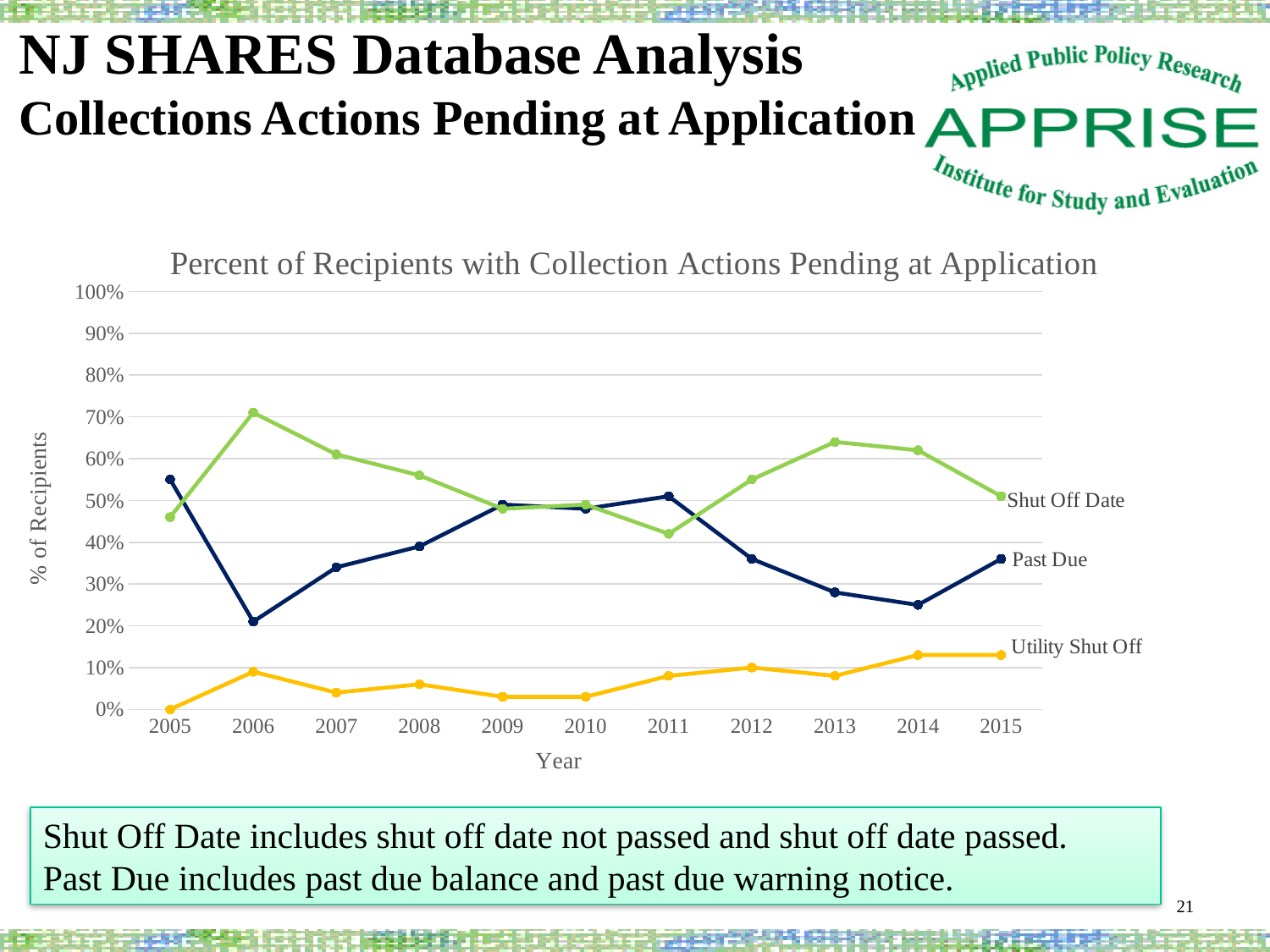
Which series has the lowest values across all years shown? Utility Shut Off In 2005, which is larger: Past Due or Shut Off Date? Past Due In 2013, which is larger: Shut Off Date or Past Due? Shut Off Date Is the value for Past Due in 2006 greater or less than 30%? less How many series are plotted in the chart? 3 In which year is the Shut Off Date series at its highest? 2006 What is the value for Utility Shut Off in 2005? 0% Is the value for Utility Shut Off in 2014 greater or less than 20%? less Does the Past Due series rise or fall from 2011 to 2014? fall How many years are shown on the x axis of the chart? 11 Is the value for Shut Off Date in 2006 greater or less than 60%? greater What kind of chart is shown on the slide? line chart